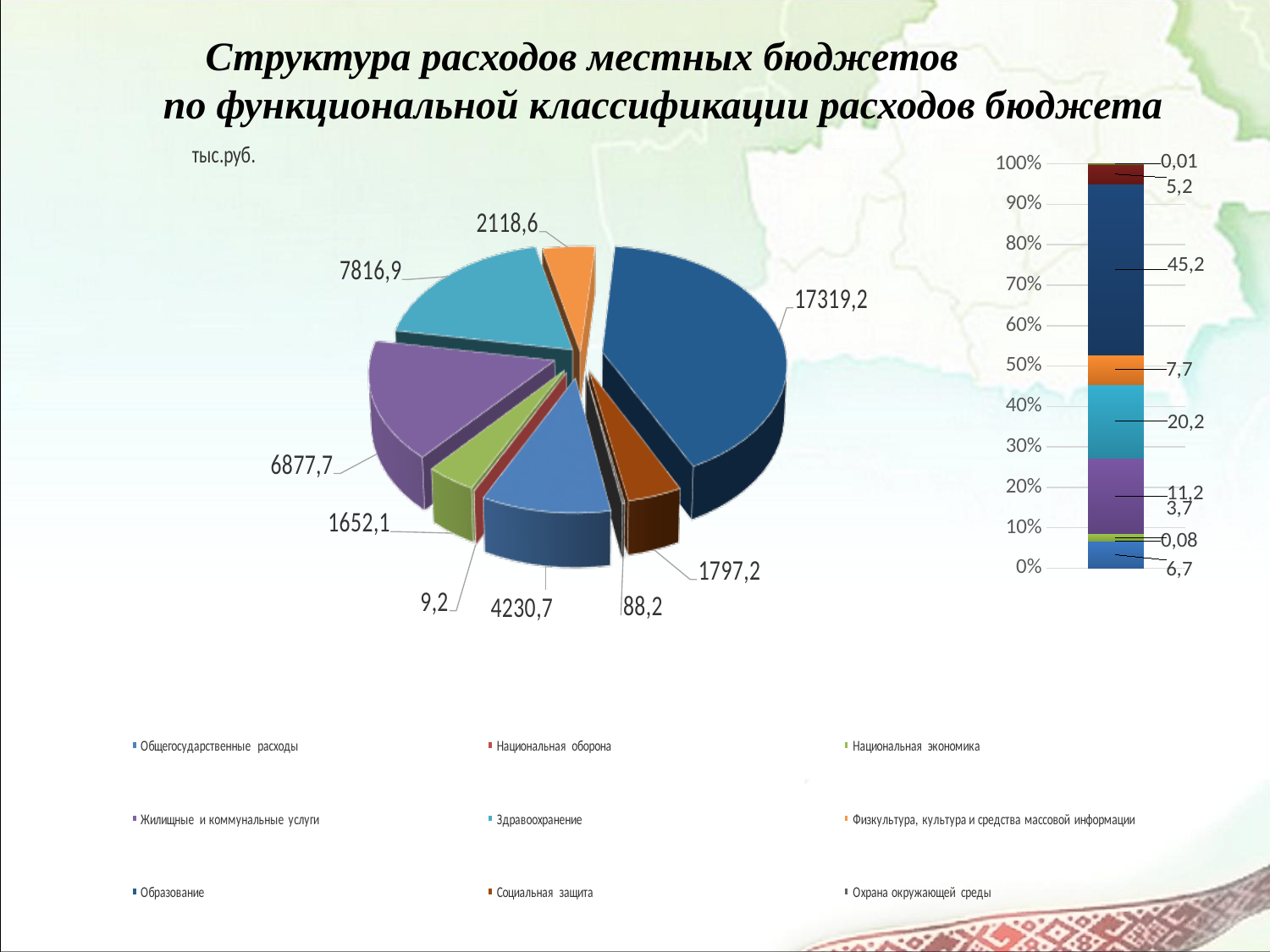
In the stacked bar chart, what is the smallest labelled segment value? 0,01 What unit is shown above the pie chart? тыс.руб. How many slices does the pie chart have? 9 In the stacked bar chart, what is the largest labelled segment value? 45,2 In the pie chart, what is the difference between the largest slice (17319,2) and the slice labelled 7816,9? 9502,3 What type of chart is on the right side of the slide? stacked bar chart In the pie chart, what value is labelled on the orange slice? 2118,6 How many categories does the legend list? 9 What type of chart is on the left side of the slide? pie chart In the pie chart, what is the smallest labelled value? 9,2 In the pie chart, which is larger: the slice labelled 7816,9 or the slice labelled 6877,7? 7816,9 In the pie chart, what is the value labelled on the largest slice? 17319,2